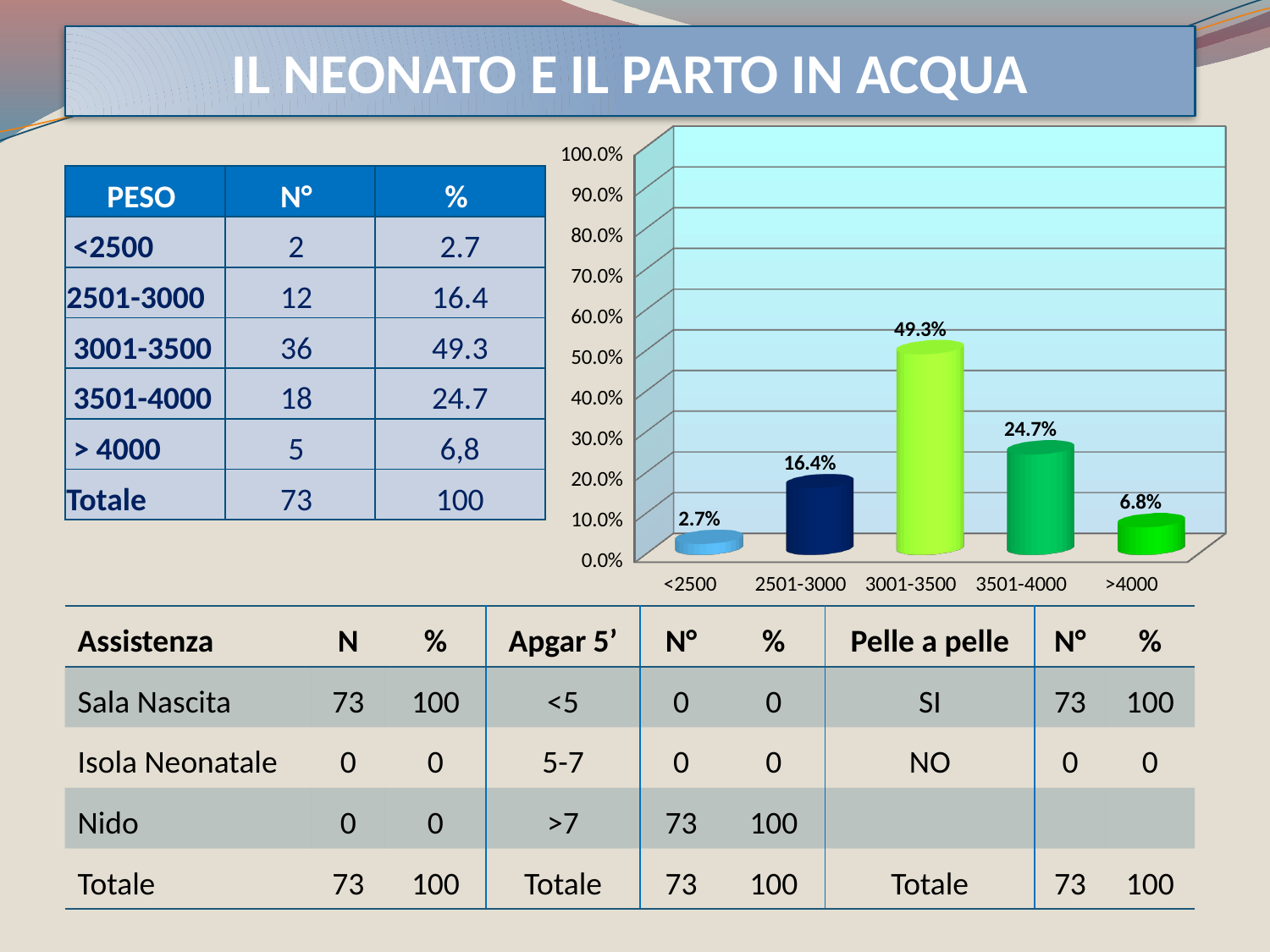
What is the highest value shown on the y axis of the chart? 100.0% What kind of chart is shown on the slide? bar chart What is the value for the 3001-3500 category in the chart? 49.3% Is the value for 3501-4000 greater or less than 20.0%? greater What is the difference between the values for 2501-3000 and <2500? 13.7% How many categories are shown on the x axis of the chart? 5 What is the value for the <2500 category in the chart? 2.7% Which category has the lowest value in the chart? <2500 Which is larger, the value for 2501-3000 or the value for >4000? 2501-3000 What is the value for the >4000 category in the chart? 6.8% Which category has the highest value in the chart? 3001-3500 What is the difference between the values for 3001-3500 and 3501-4000? 24.6%